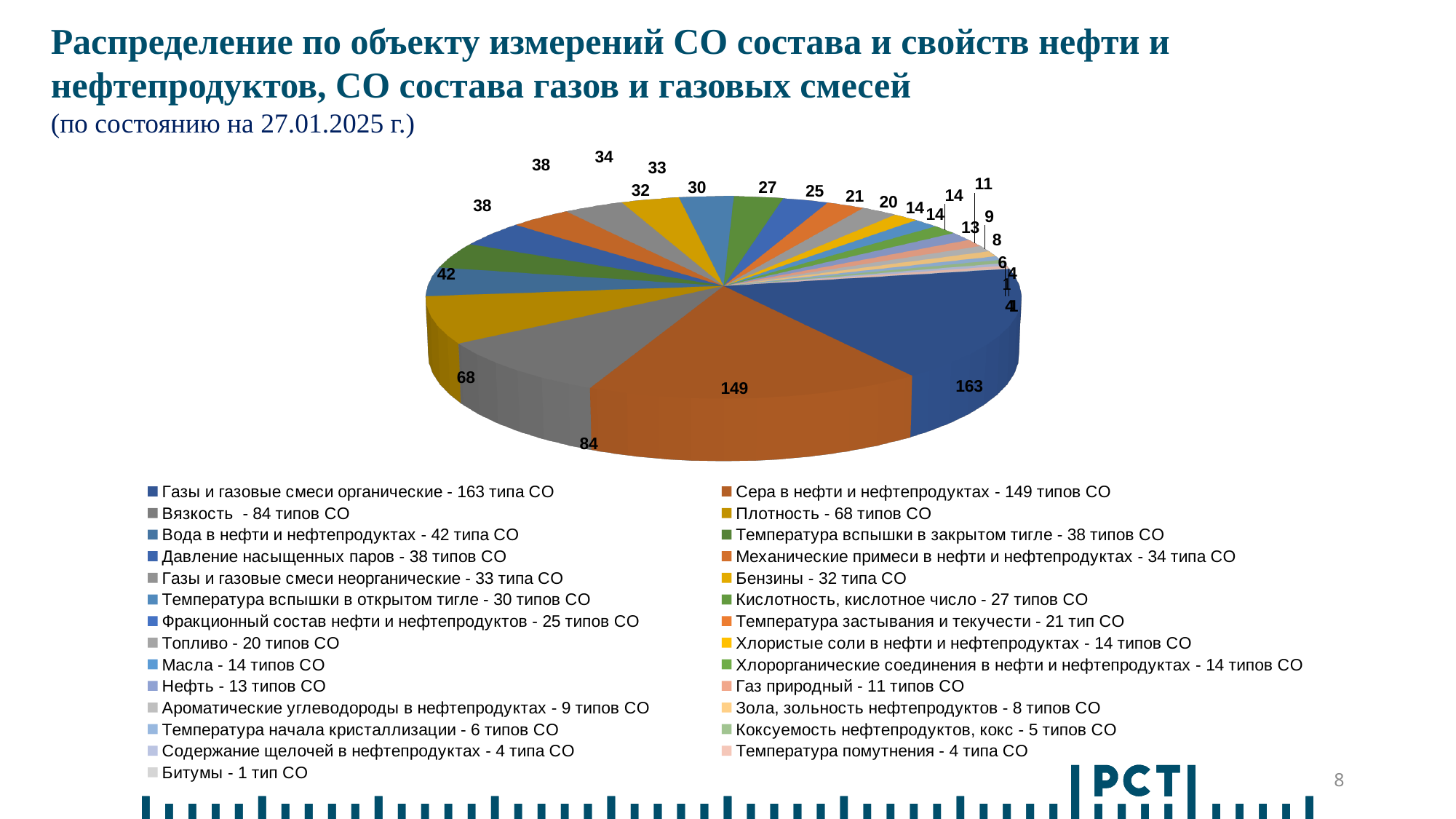
What is the difference between the values for Вязкость and Плотность? 16 Which is larger: Нефть or Топливо? Топливо What is the difference between the values for Газы и газовые смеси органические and Сера в нефти и нефтепродуктах? 14 Which is larger: Вода в нефти и нефтепродуктах or Бензины? Вода в нефти и нефтепродуктах What value is shown for Газ природный? 11 What value is shown for Плотность? 68 What kind of chart is shown on the slide? pie chart What value is shown for Вязкость? 84 Which category has the largest slice in the pie chart? Газы и газовые смеси органические How many types of CO are shown for Сера в нефти и нефтепродуктах? 149 How many categories does the pie chart contain? 27 Which category has the smallest slice in the pie chart? Битумы